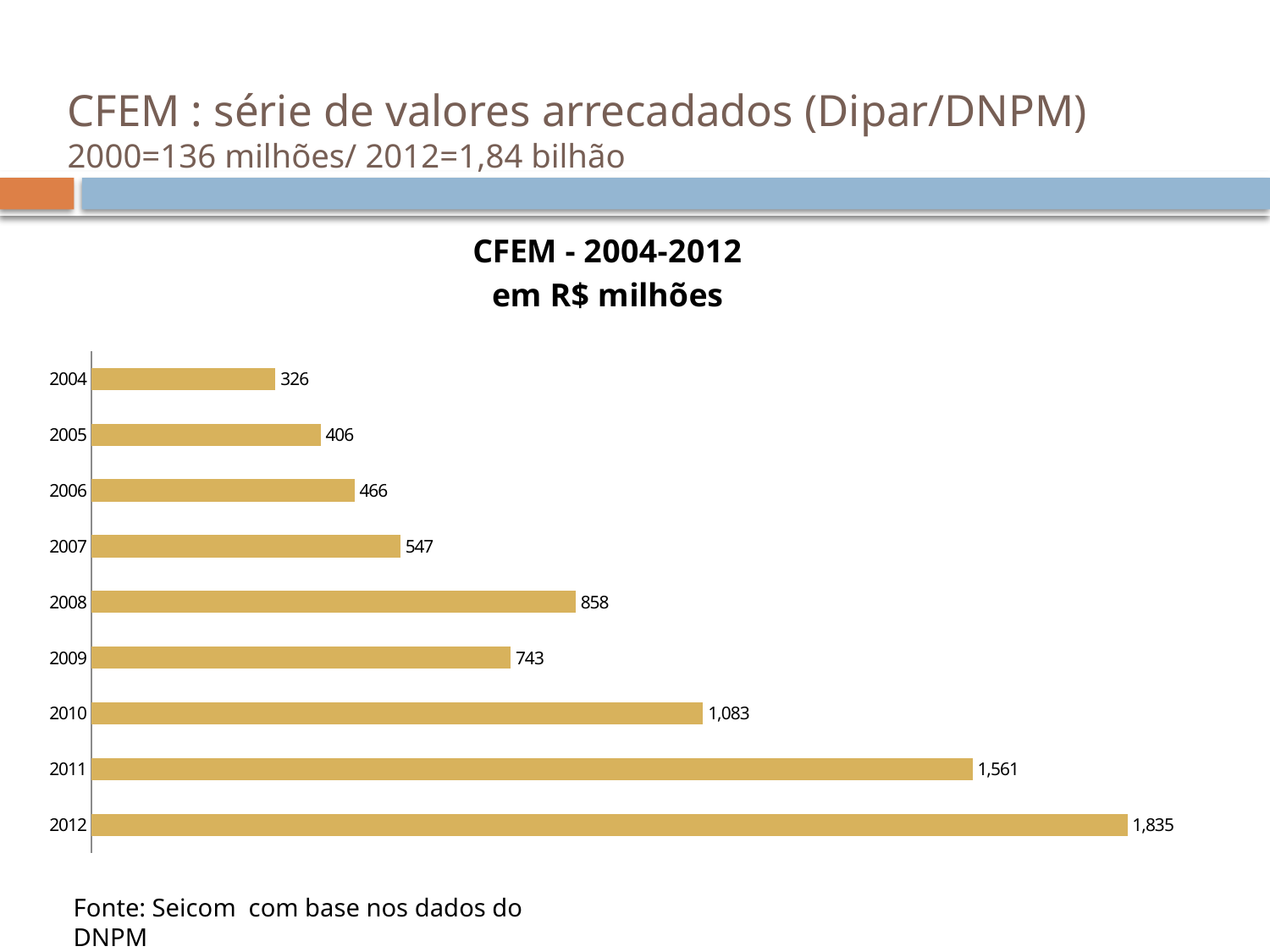
What is the value for 2008? 858 What is the difference between the values for 2008 and 2009? 115 How many years are shown in the chart? 9 Do the values generally rise or fall from 2004 to 2012? rise What kind of chart is shown? bar chart What is the title of the chart? CFEM - 2004-2012 em R$ milhões Which is larger, the value for 2008 or the value for 2009? 2008 What is the value for 2004? 326 What is the difference between the values for 2012 and 2011? 274 Which year has the lowest value? 2004 Which year has the highest value? 2012 What is the value for 2012? 1,835